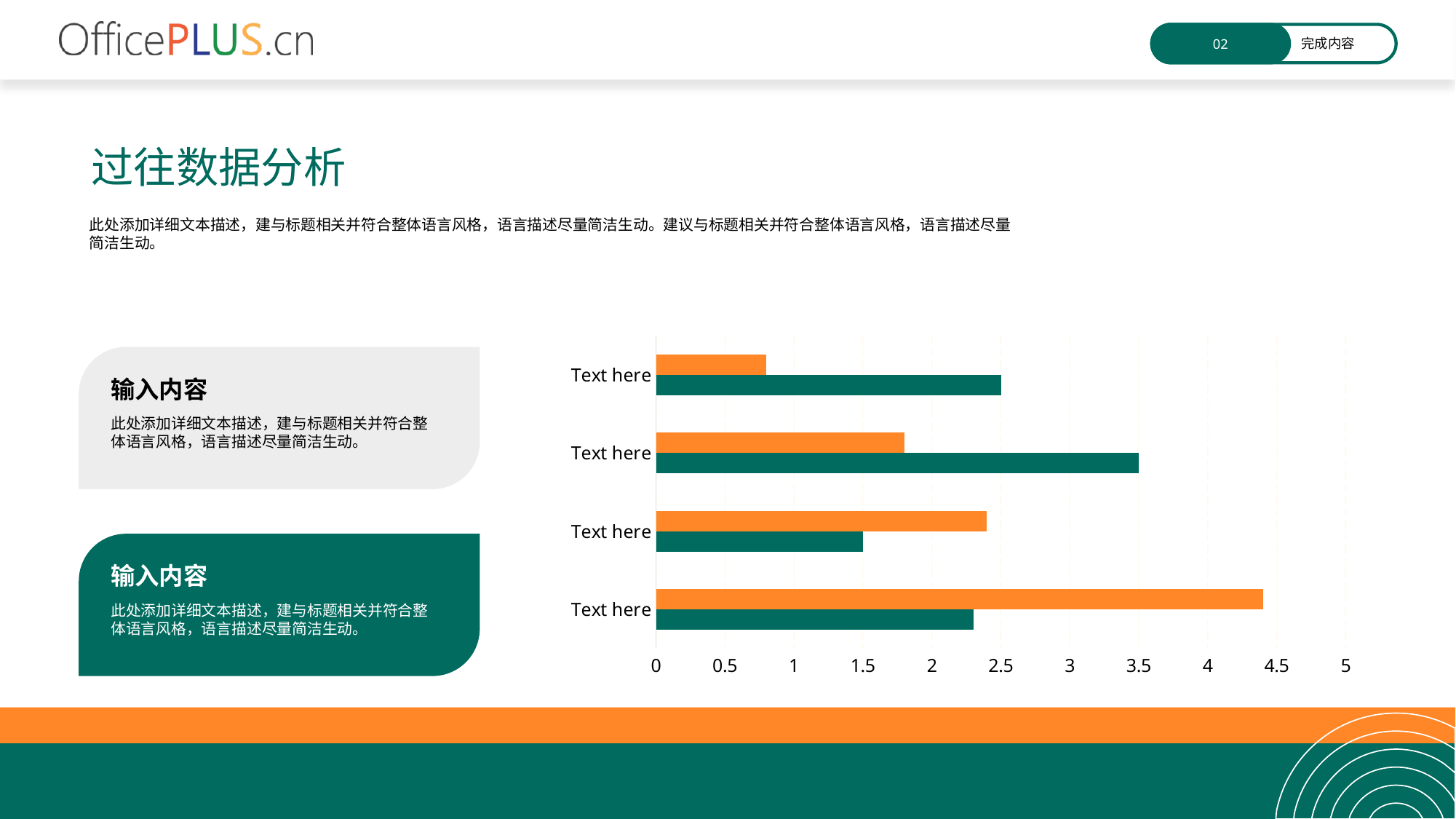
Is the orange bar for the topmost category greater or less than 1? less Which category has the shortest orange bar? the top category What is the value of the green bar for the topmost category? 2.5 What is the value of the green bar for the third category from the top? 1.5 How many data series are plotted on the chart? 2 What kind of chart is shown on the slide? bar chart Is the orange bar for the bottom category greater or less than 4? greater How many categories are plotted on the chart? 4 Which category has the longest orange bar? the bottom category What is the value of the green bar for the second category from the top? 3.5 What is the maximum value shown on the horizontal axis? 5 For the third category from the top, which bar is longer, the orange or the green? orange